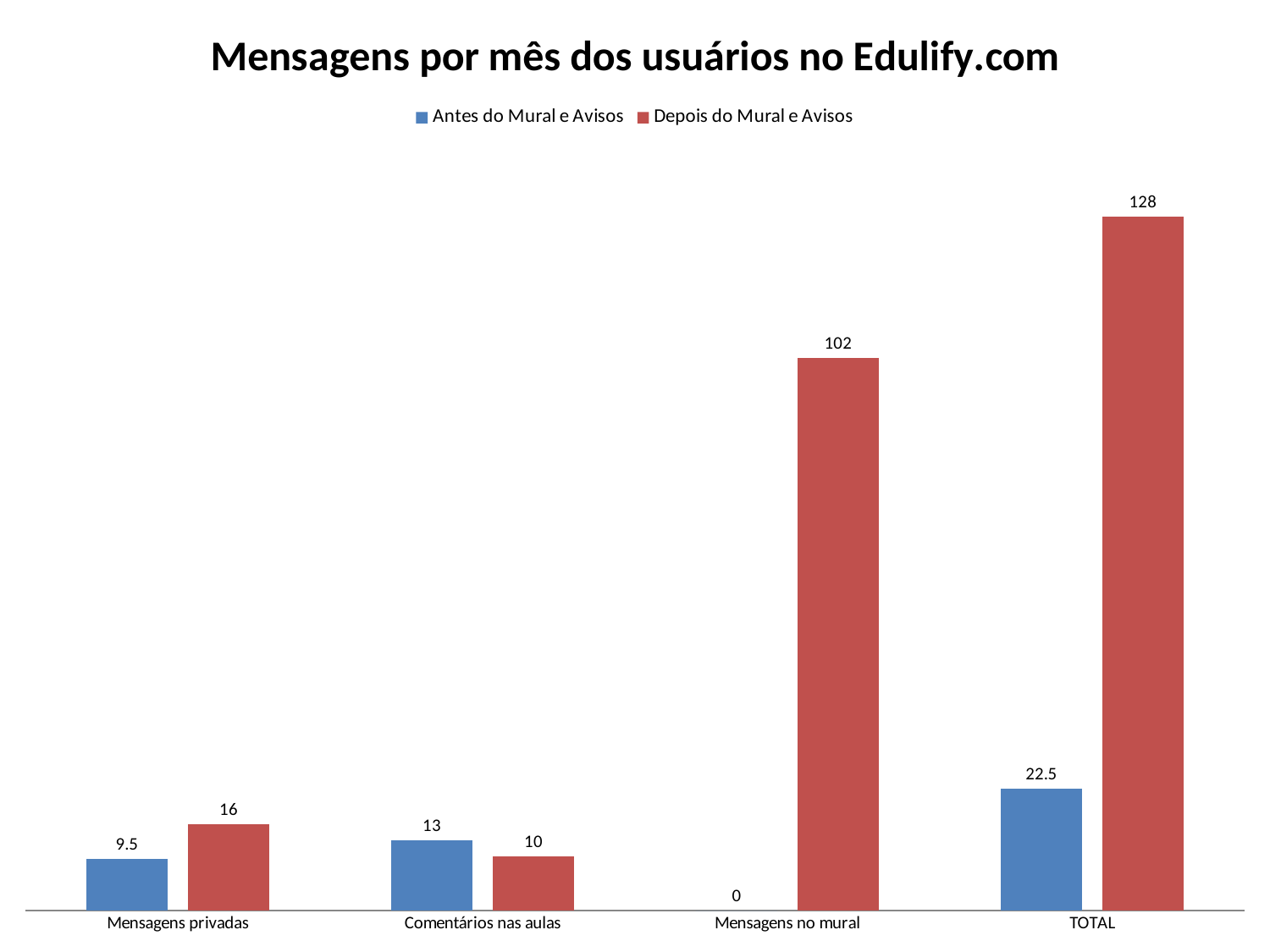
What is the value for Mensagens no mural in the Depois do Mural e Avisos series? 102 What is the value for Mensagens privadas in the Antes do Mural e Avisos series? 9.5 How many categories are shown on the x axis? 4 What is the title of the chart? Mensagens por mês dos usuários no Edulify.com What is the TOTAL value for the Depois do Mural e Avisos series? 128 For Comentários nas aulas, which series has the larger value, Antes do Mural e Avisos or Depois do Mural e Avisos? Antes do Mural e Avisos How many series does the legend list? 2 What is the difference between the Depois do Mural e Avisos and Antes do Mural e Avisos values for TOTAL? 105.5 What is the value for Comentários nas aulas in the Antes do Mural e Avisos series? 13 What kind of chart is shown on the slide? Bar chart Which category has the lowest value in the Antes do Mural e Avisos series? Mensagens no mural Which category has the highest value in the Depois do Mural e Avisos series? TOTAL